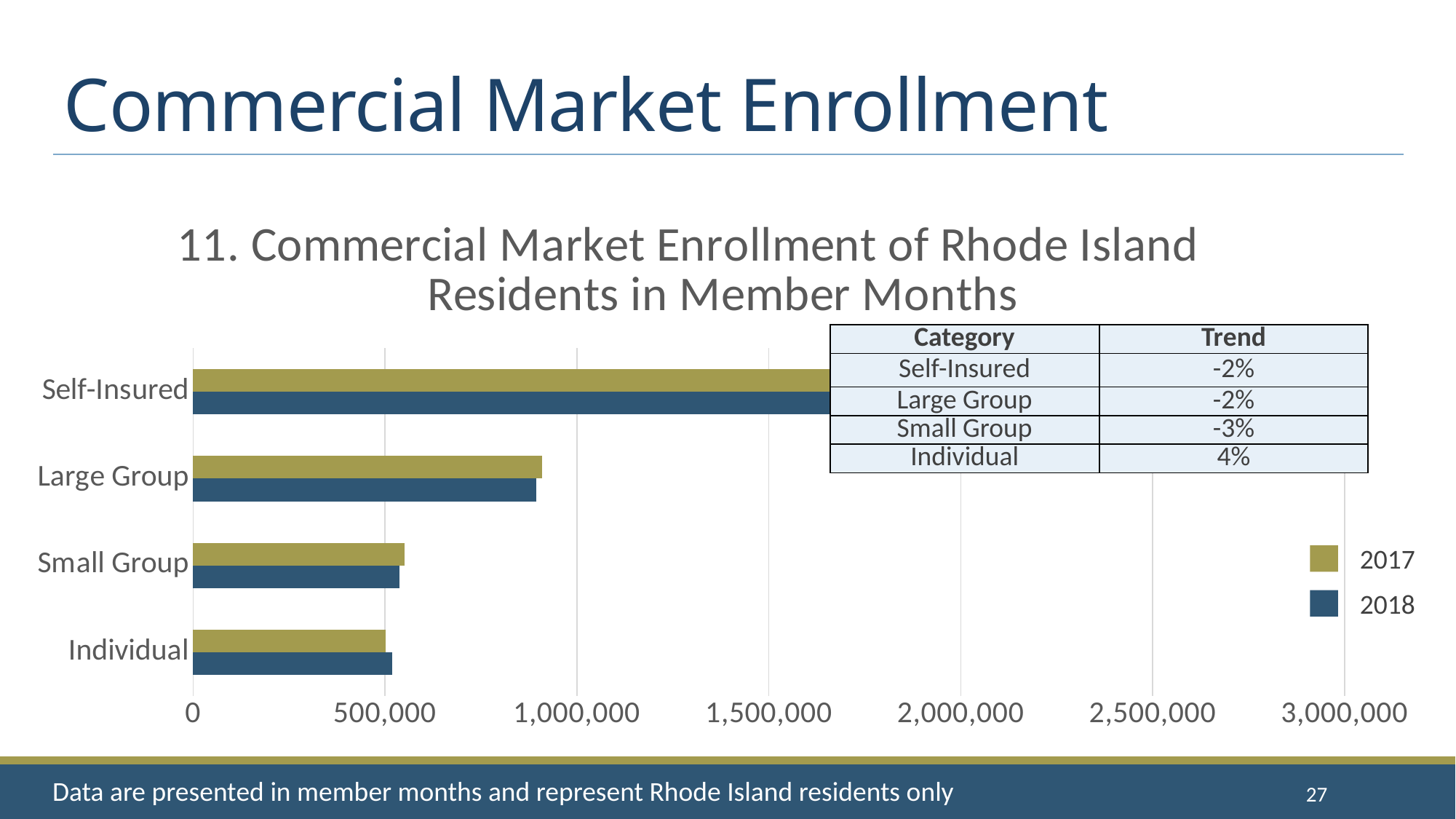
Which is larger in 2017, the value for Large Group or the value for Small Group? Large Group Is the 2017 value for Large Group greater or less than 500,000? greater How many series does the chart legend list? 2 Is the 2018 value for Self-Insured greater or less than 1,500,000? greater Which category has the lowest enrollment in 2017? Individual Which is larger in 2018, the value for Self-Insured or the value for Large Group? Self-Insured What are the two years listed in the chart legend? 2017 and 2018 According to the trend table on the chart, what is the trend for Individual? 4% What kind of chart is shown on the slide? bar chart Which category has the highest enrollment in 2018? Self-Insured How many categories are plotted on the chart? 4 Is the 2017 value for Large Group greater or less than 1,000,000? less